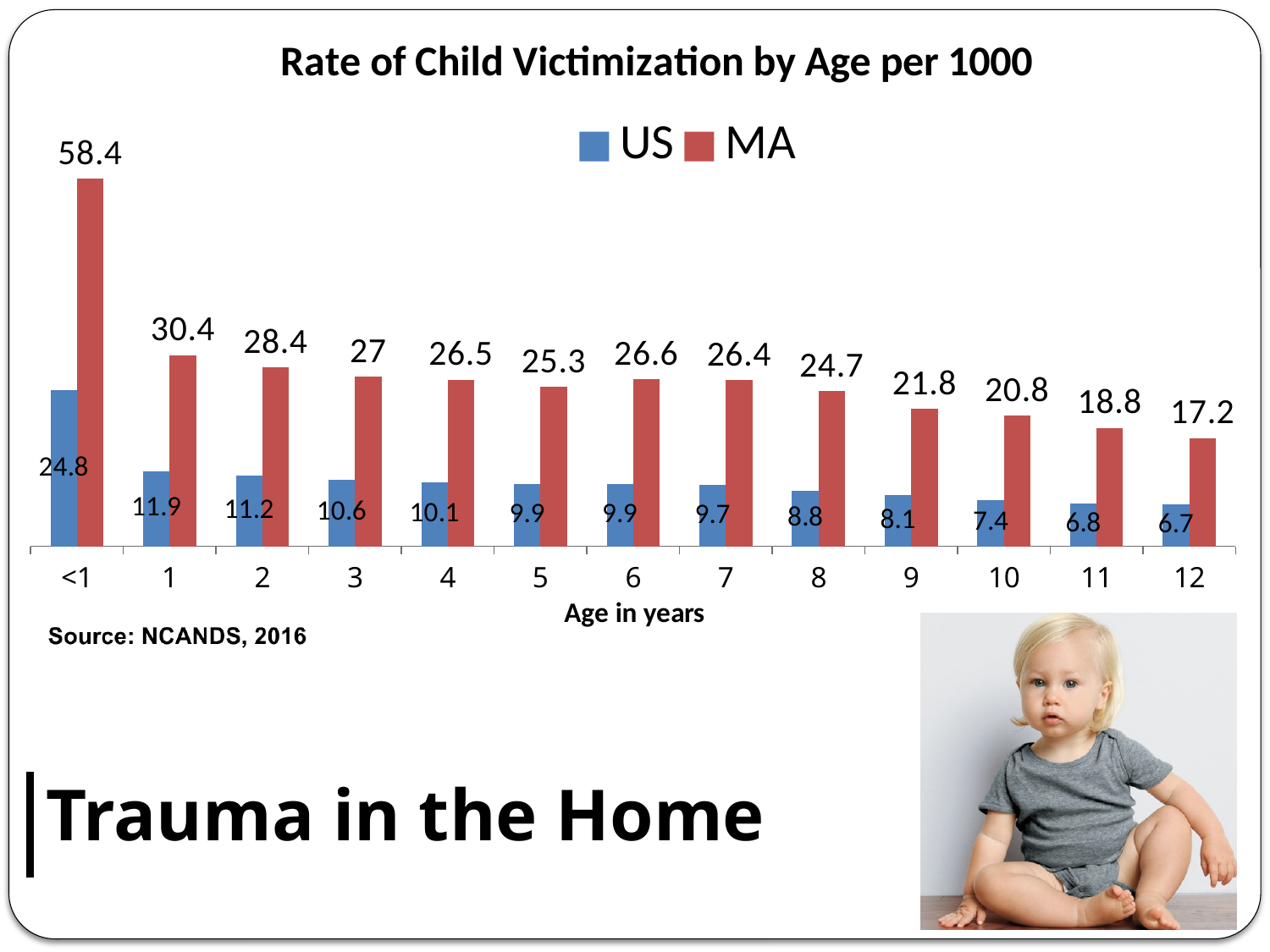
What is the MA rate of child victimization for children under 1 year old? 58.4 Which is larger, the US rate at age 3 or the US rate at age 9? US rate at age 3 What is the title of the chart? Rate of Child Victimization by Age per 1000 How many age categories are shown on the x axis? 13 How many series does the legend list? 2 Which age group has the highest MA rate? <1 What is the difference between the MA rate at age 1 and the MA rate at age 2? 2 What is the difference between the MA and US rates for children under 1? 33.6 What is the US rate of child victimization for age 5? 9.9 What is the MA value for age 12? 17.2 What kind of chart is shown on the slide? Bar chart Which age group has the lowest US rate? 12